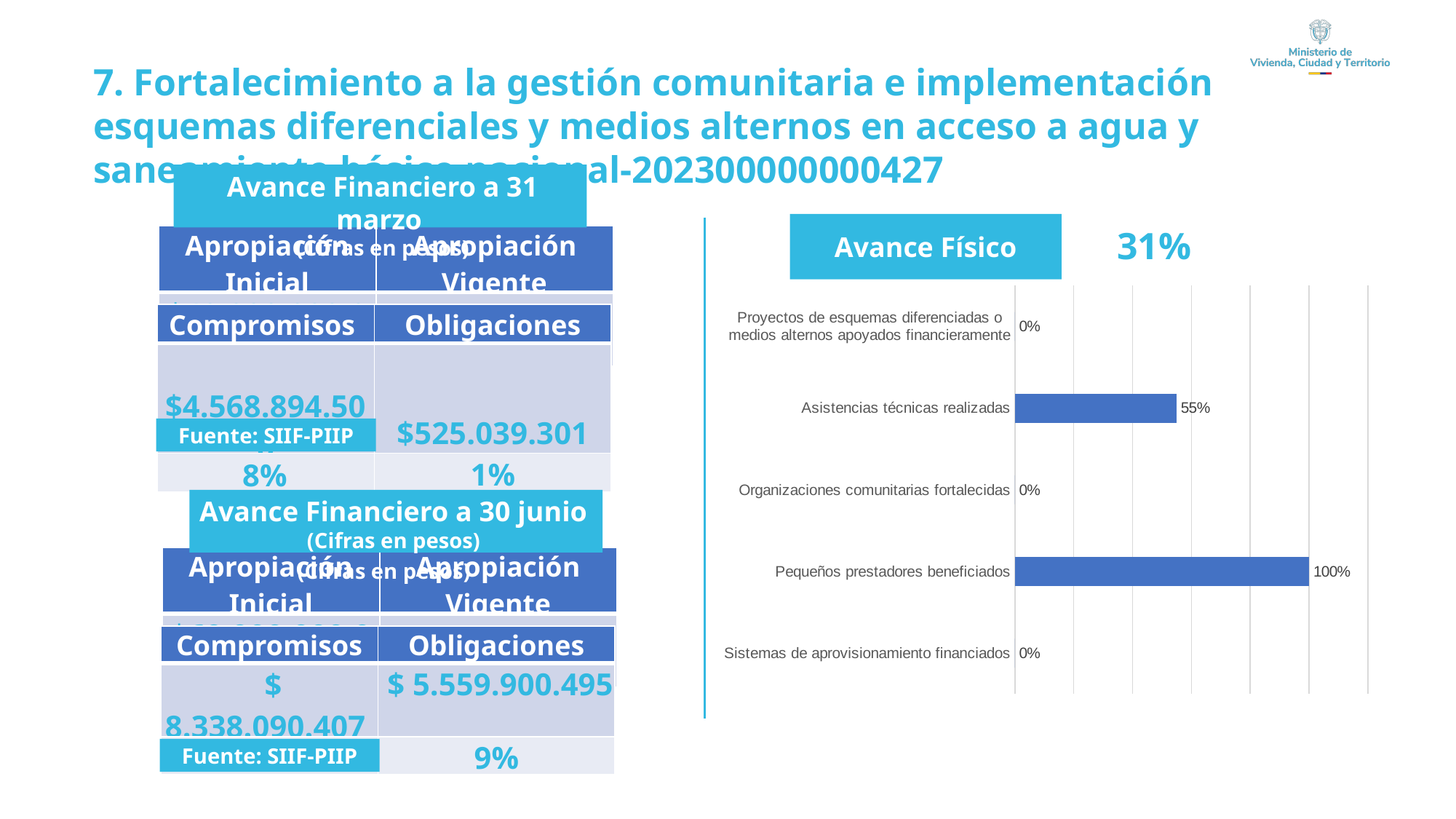
What is the value for Sistemas de aprovisionamiento financiados in the Avance Físico chart? 0% Which category has the highest value in the Avance Físico chart? Pequeños prestadores beneficiados What is the difference between Pequeños prestadores beneficiados and Asistencias técnicas realizadas in the Avance Físico chart? 45% What is the value for Organizaciones comunitarias fortalecidas in the Avance Físico chart? 0% What is the title of the chart on the right side of the slide? Avance Físico How many categories are shown in the Avance Físico chart? 5 How many categories in the Avance Físico chart have a value of 0%? 3 Which is larger in the Avance Físico chart: Asistencias técnicas realizadas or Organizaciones comunitarias fortalecidas? Asistencias técnicas realizadas What overall percentage is shown next to the Avance Físico title? 31% What is the value for Asistencias técnicas realizadas in the Avance Físico chart? 55% What kind of chart is the Avance Físico chart? Bar chart What is the value for Pequeños prestadores beneficiados in the Avance Físico chart? 100%